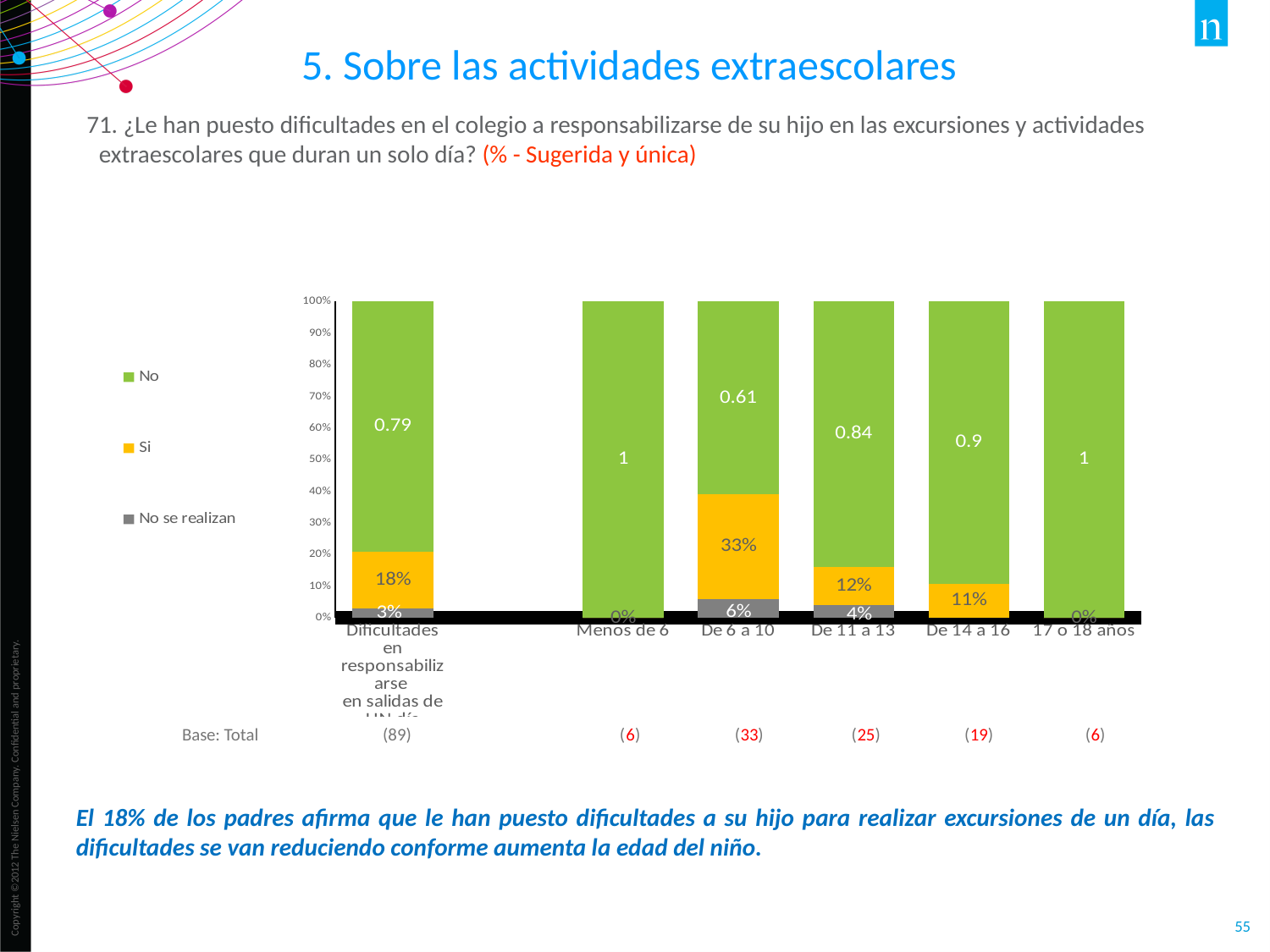
Which age group has the highest 'Si' value? De 6 a 10 What is the value of the 'Si' segment for the 'De 6 a 10' age group? 33% What is the difference between the 'Si' values for 'De 6 a 10' and 'De 11 a 13'? 21% Is the 'Si' value larger for 'De 11 a 13' or for 'De 14 a 16'? De 11 a 13 What label is printed on the 'No' segment for the 'De 14 a 16' age group? 0.9 What kind of chart is shown on the slide? stacked bar chart What is the value of the 'Si' segment for the 'De 11 a 13' age group? 12% Which age group has the lowest 'No' value? De 6 a 10 What are the three series listed in the legend? No, Si, No se realizan What is the value of the 'Si' segment for the 'De 14 a 16' age group? 11% What label is printed on the 'No' segment for the 'De 6 a 10' age group? 0.61 How many series does the legend list? 3